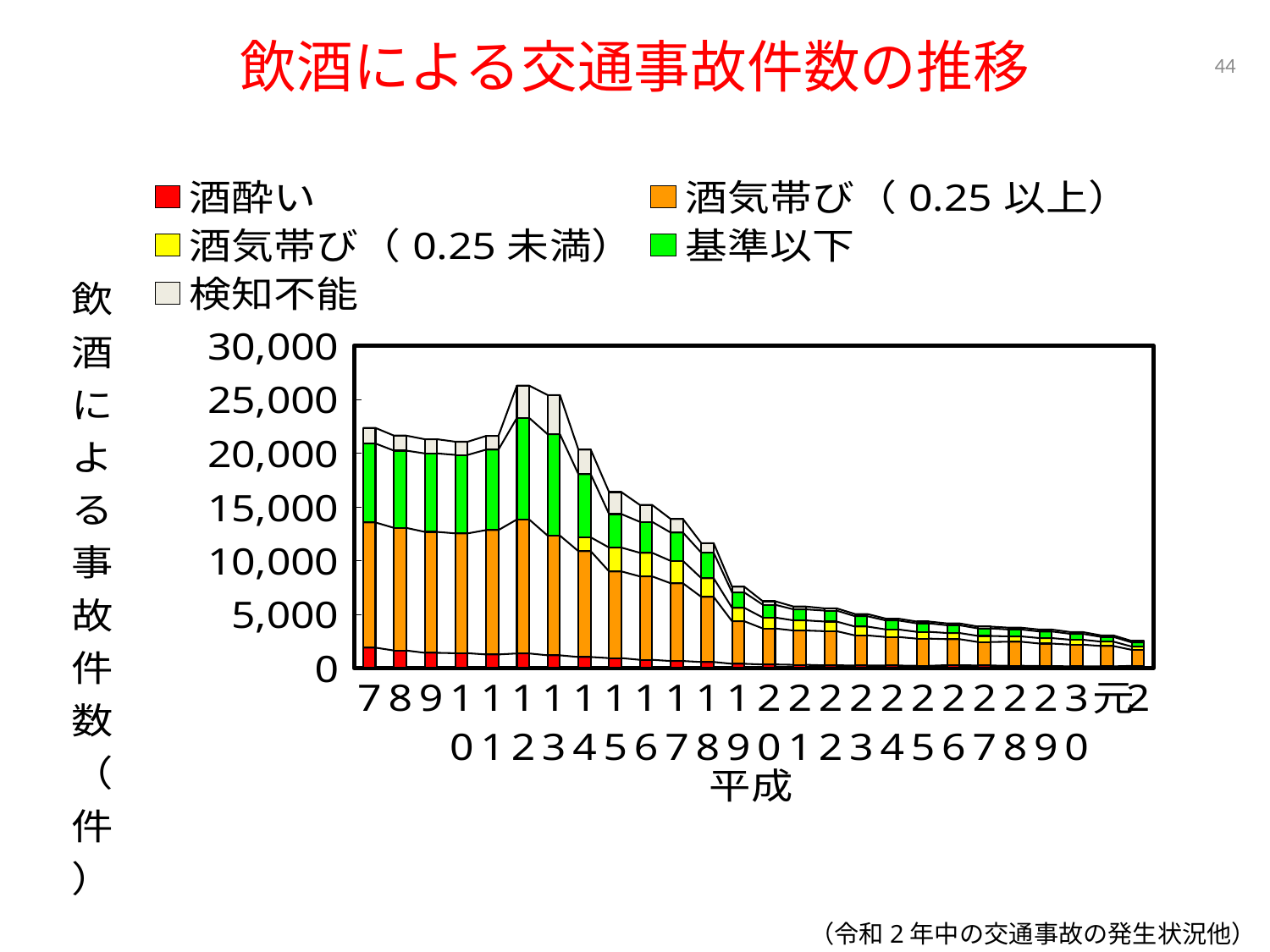
Which year has the lowest total number of drunk-driving accidents? 令和2 Overall, do the total accident counts rise or fall from 平成7 to 令和2? fall Is the total value for 令和2 greater or less than 5,000? less Which year has the highest total number of drunk-driving accidents? 平成12 How many year categories are plotted along the x axis? 26 Is the total value for 平成20 greater or less than 10,000? less What colour represents the 酒酔い series? red What is the title of the chart? 飲酒による交通事故件数の推移 How many series does the legend list? 5 Is the total value for 平成7 greater or less than 20,000? greater Which has a larger total, 平成7 or 平成20? 平成7 What kind of chart is shown on the slide? stacked bar chart